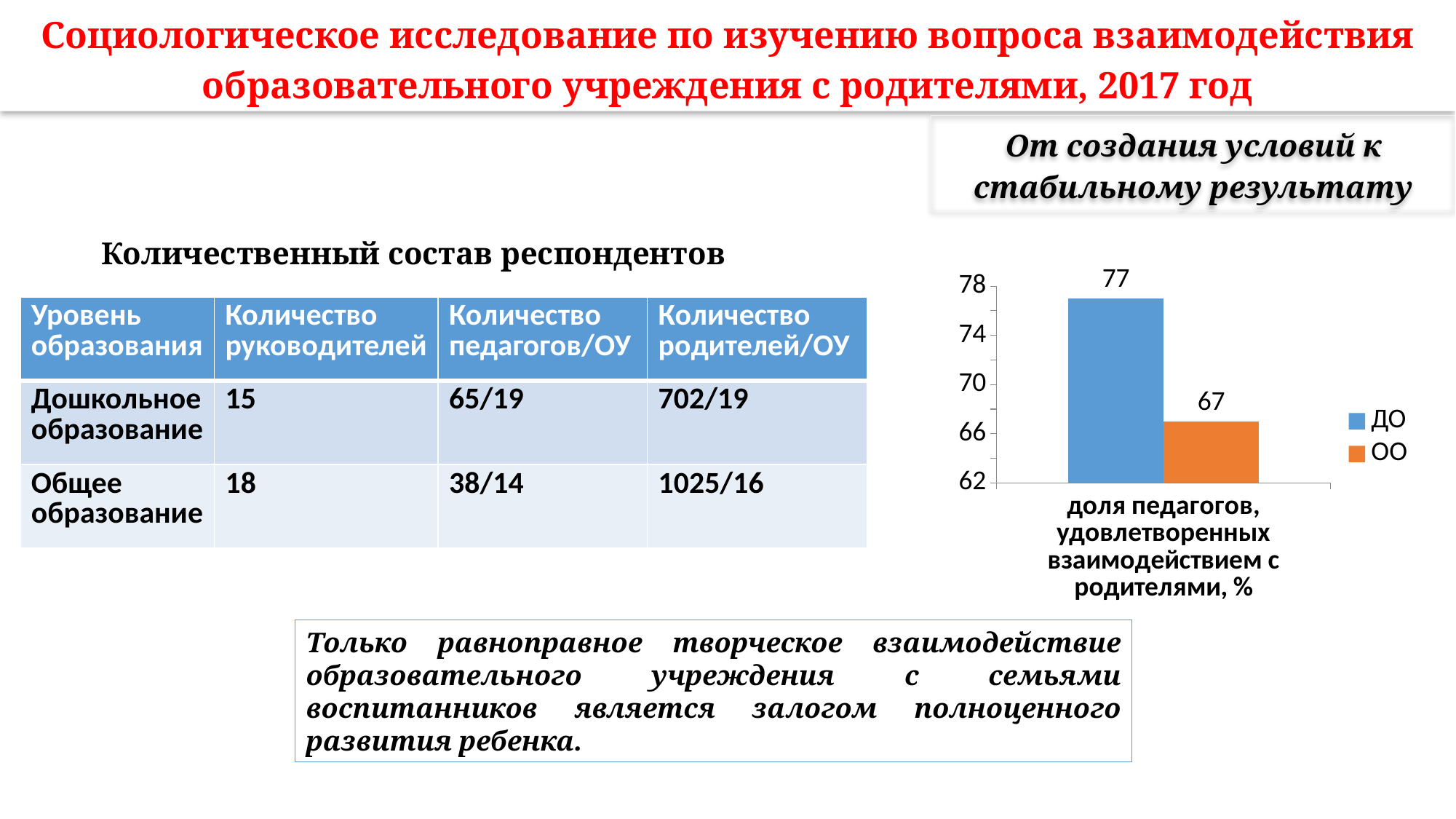
What is the value for ОО in the chart? 67 Is the value for ДО greater or less than 74? greater What is the category label on the x axis of the chart? доля педагогов, удовлетворенных взаимодействием с родителями, % Is the value for ОО greater or less than 70? less Which series has the lower value in the chart? ОО What kind of chart is shown on the slide? bar chart What is the value for ДО in the chart? 77 What is the difference between the ДО and ОО values in the chart? 10 Which series has the higher value in the chart, ДО or ОО? ДО What colour is the bar for ОО in the chart? orange What is the lowest value shown on the chart's vertical axis? 62 How many series does the chart legend list? 2